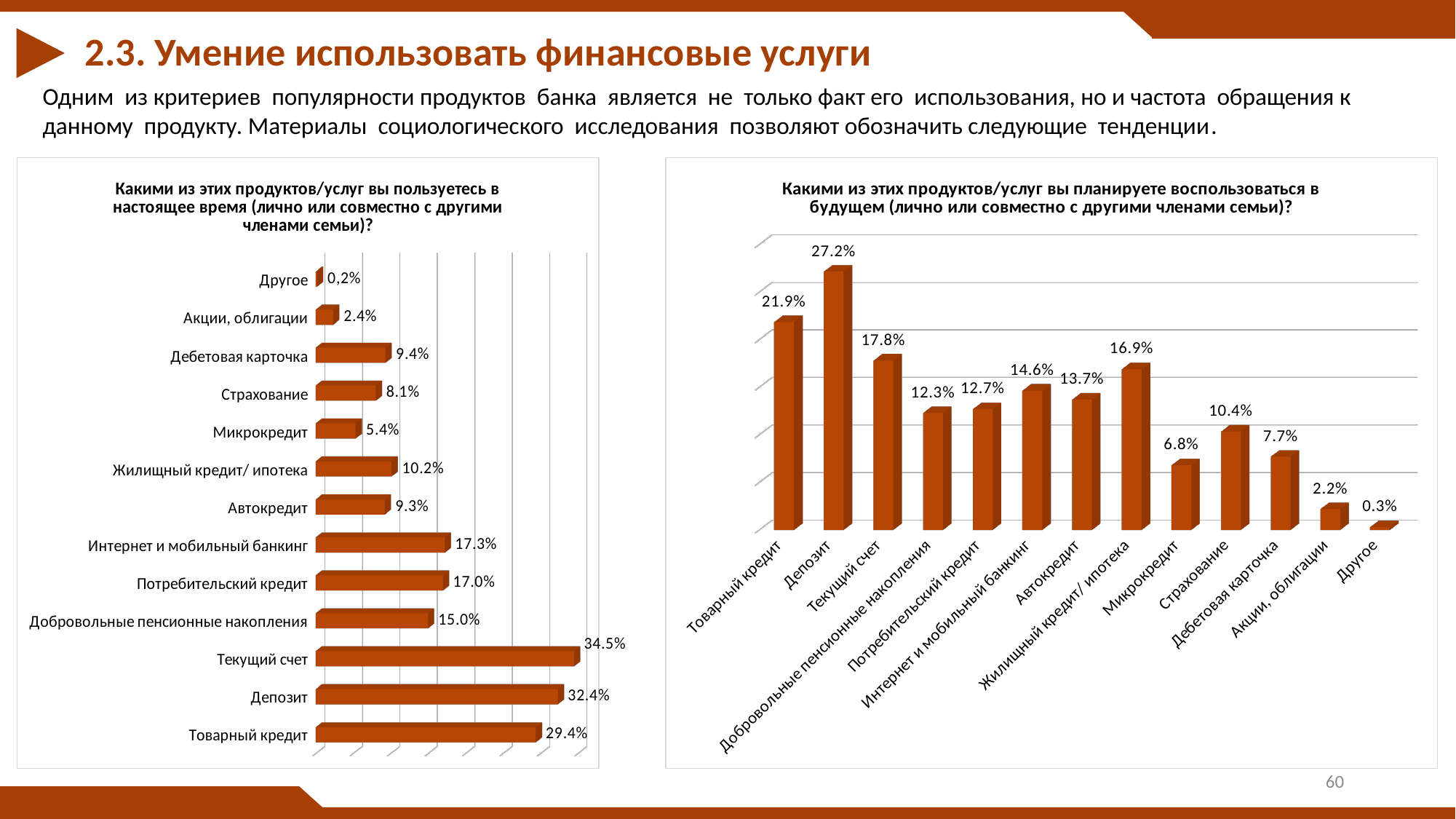
In the right chart (products/services planned for the future), what is the value for Депозит? 27.2% In the left chart (products/services used at present), which category has the highest value? Текущий счет In the right chart (products/services planned for the future), what is the value for Жилищный кредит/ ипотека? 16.9% In the right chart (products/services planned for the future), what is the difference between Товарный кредит and Текущий счет? 4.1% In the left chart (products/services used at present), what is the value for Интернет и мобильный банкинг? 17.3% In the right chart (products/services planned for the future), which category has the lowest value? Другое In the right chart (products/services planned for the future), which is larger: Страхование or Дебетовая карточка? Страхование In the left chart (products/services used at present), what is the value for Текущий счет? 34.5% How many categories are shown in the left chart (products/services used at present)? 13 What type of chart is the right chart (products/services planned for the future)? Bar chart In the left chart (products/services used at present), what is the difference between Депозит and Товарный кредит? 3.0% In the left chart (products/services used at present), which is larger: Дебетовая карточка or Автокредит? Дебетовая карточка